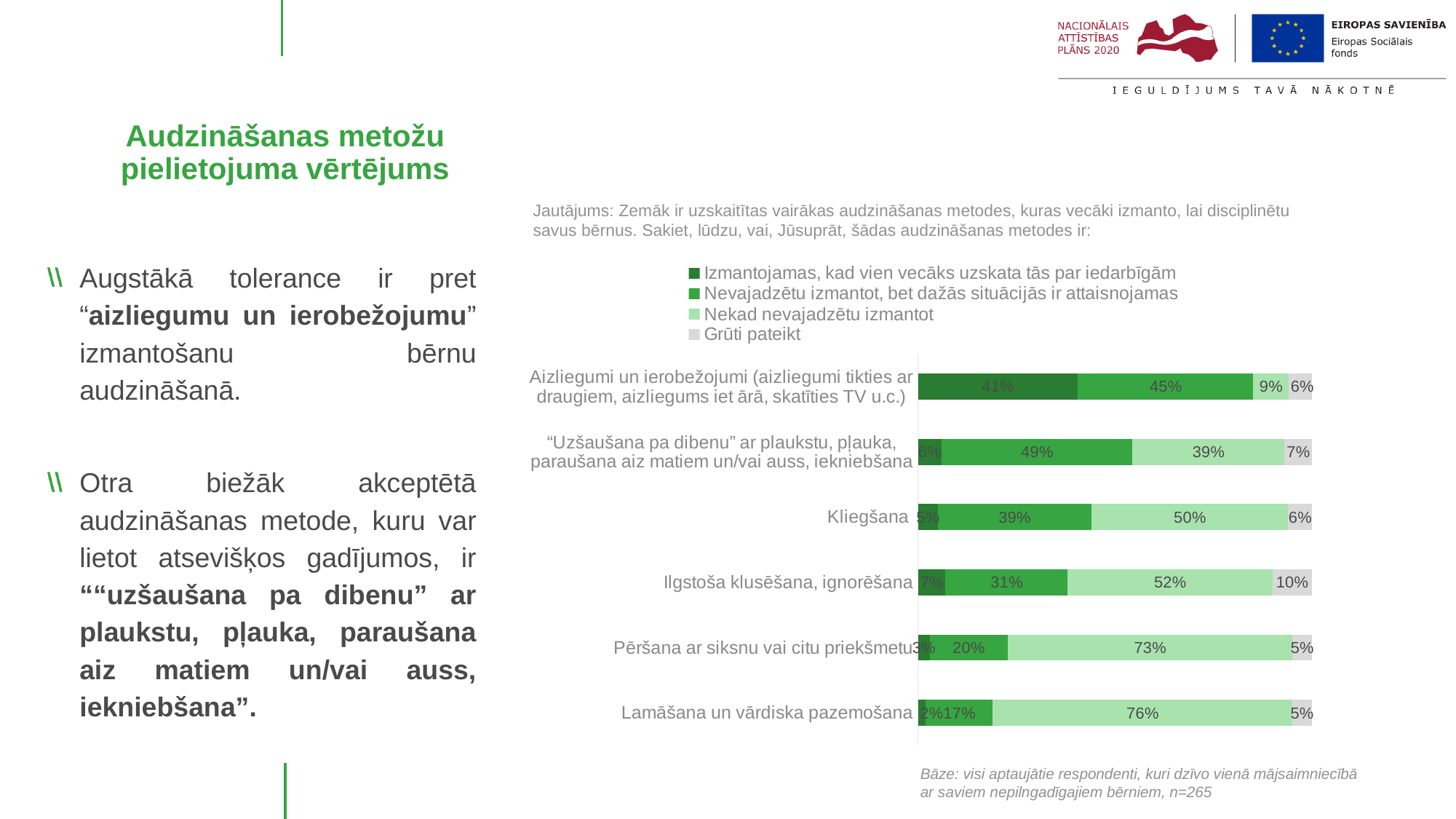
What is the value of "Izmantojamas, kad vien vecāks uzskata tās par iedarbīgām" for "Aizliegumi un ierobežojumi"? 41% What is the value of "Nevajadzētu izmantot, bet dažās situācijās ir attaisnojamas" for "Kliegšana"? 39% How many categories (audzināšanas metodes) are plotted in the chart? 6 What is the value of "Grūti pateikt" for "Ilgstoša klusēšana, ignorēšana"? 10% Which category has the highest value for "Izmantojamas, kad vien vecāks uzskata tās par iedarbīgām"? Aizliegumi un ierobežojumi Which colour represents the "Grūti pateikt" series in the chart? Grey For "Aizliegumi un ierobežojumi", what is the difference between the "Nevajadzētu izmantot, bet dažās situācijās ir attaisnojamas" value and the "Izmantojamas, kad vien vecāks uzskata tās par iedarbīgām" value? 4 percentage points Which has a larger "Nekad nevajadzētu izmantot" value: "Kliegšana" or "Ilgstoša klusēšana, ignorēšana"? Ilgstoša klusēšana, ignorēšana What kind of chart is shown on the slide? Stacked bar chart What is the value of "Nekad nevajadzētu izmantot" for "Lamāšana un vārdiska pazemošana"? 76% Which category has the highest value for "Nekad nevajadzētu izmantot"? Lamāšana un vārdiska pazemošana How many series does the chart legend list? 4